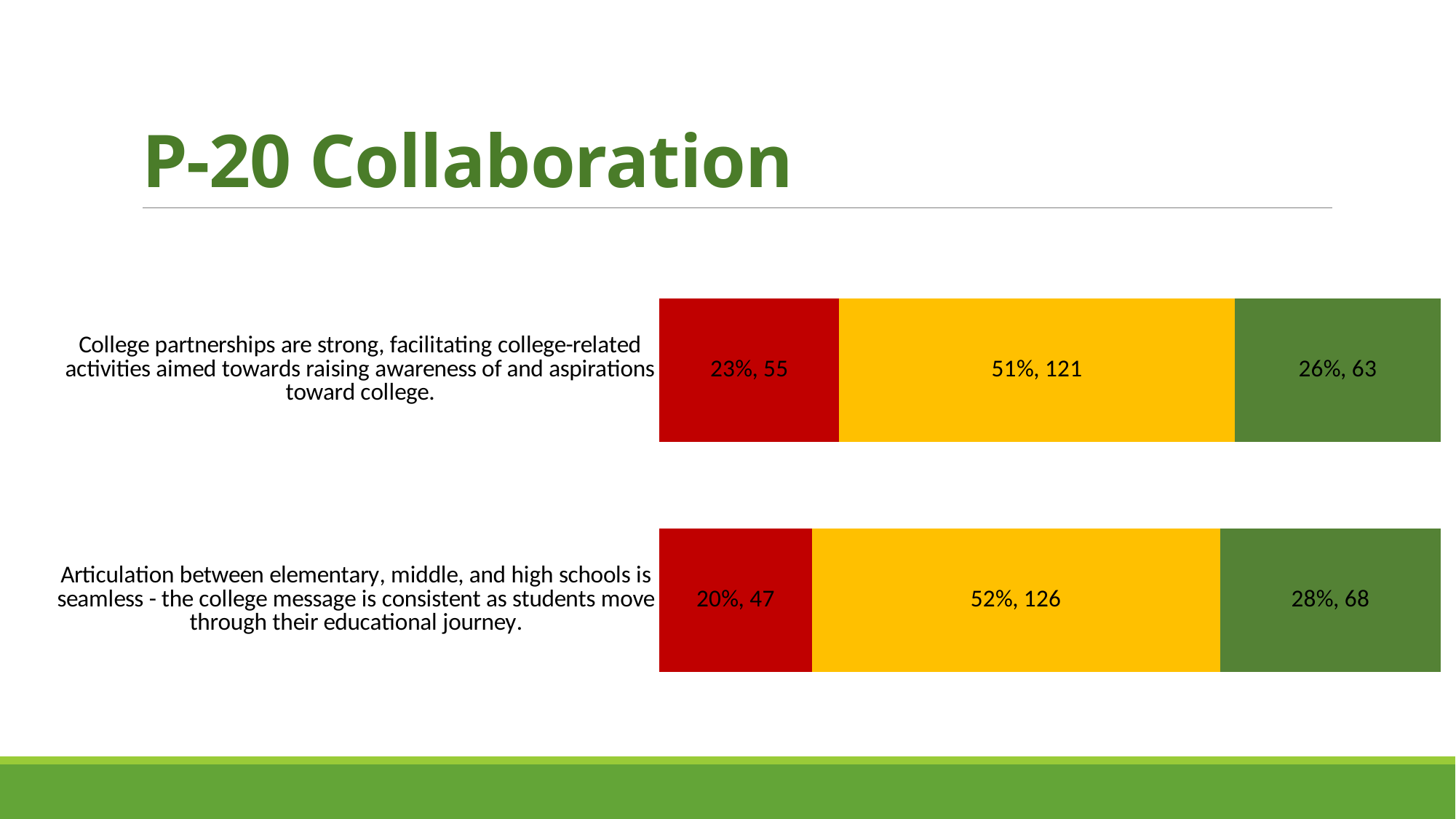
What is the label on the yellow segment of the bar for "College partnerships are strong..."? 51%, 121 How many categories (bars) does the chart show? 2 Which segment of the "Articulation between elementary, middle, and high schools is seamless..." bar has the smallest count? The red segment (20%, 47) What is the total count across all three segments of the "College partnerships are strong..." bar? 239 What is the label on the green segment of the bar for "Articulation between elementary, middle, and high schools is seamless..."? 28%, 68 Which segment of the "College partnerships are strong..." bar has the largest count? The yellow segment (51%, 121) What is the difference in count between the yellow segments of the two bars (126 vs 121)? 5 Which bar has the larger green-segment count, "College partnerships are strong..." or "Articulation between elementary, middle, and high schools is seamless..."? Articulation between elementary, middle, and high schools is seamless... (68) How many coloured segments make up each bar? 3 What kind of chart is shown on the slide? Stacked bar chart What is the label on the red segment of the bar for "Articulation between elementary, middle, and high schools is seamless..."? 20%, 47 What is the label on the red segment of the bar for "College partnerships are strong..."? 23%, 55